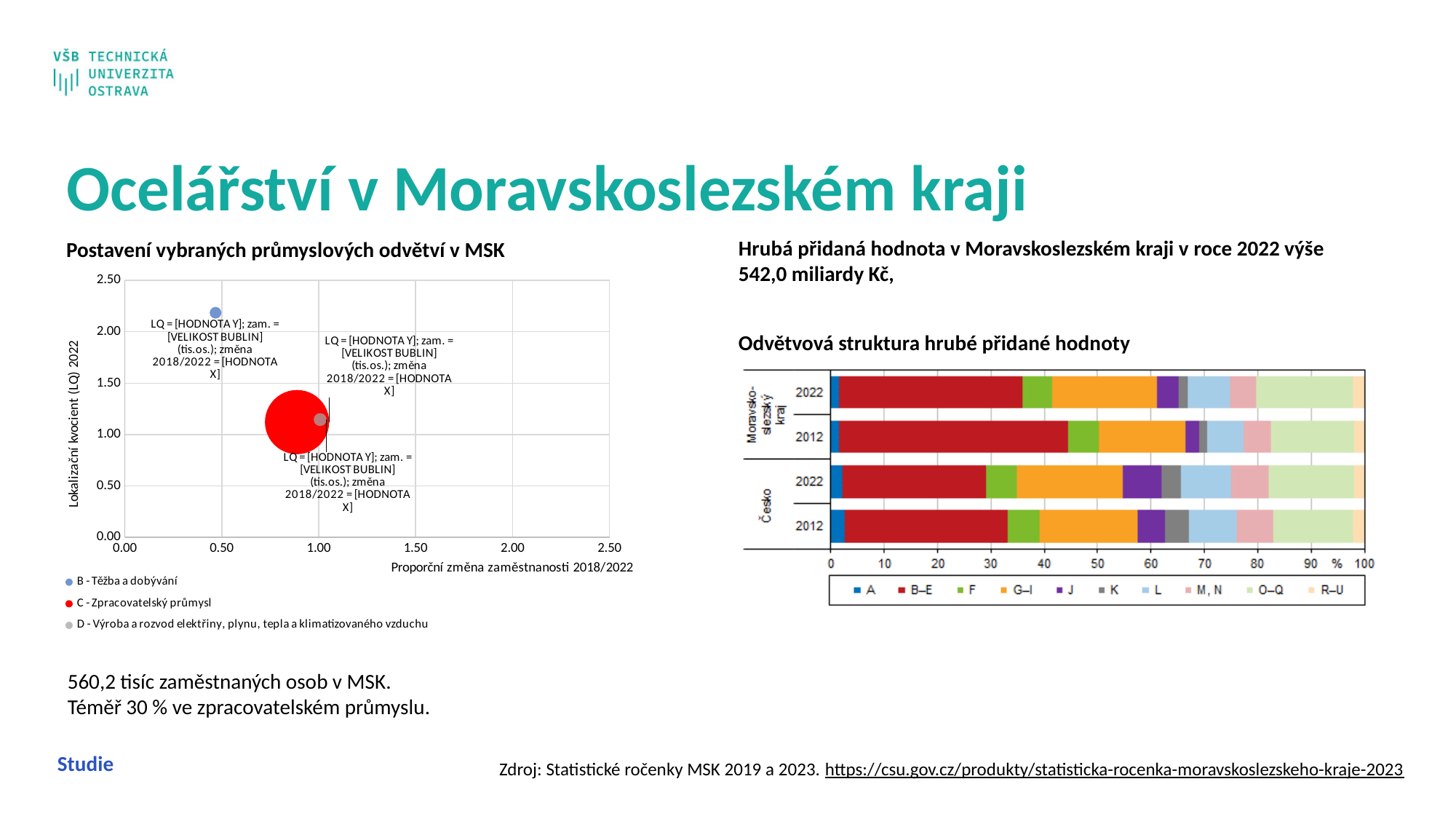
In the left chart 'Postavení vybraných průmyslových odvětví v MSK', what is the label of the x axis? Proporční změna zaměstnanosti 2018/2022 In the left chart 'Postavení vybraných průmyslových odvětví v MSK', is the LQ value for B - Těžba a dobývání greater or less than 2.00? greater In the right chart 'Odvětvová struktura hrubé přidané hodnoty', which has the larger share of B–E in 2022: Moravskoslezský kraj or Česko? Moravskoslezský kraj In the right chart 'Odvětvová struktura hrubé přidané hodnoty', how many series does the legend list? 10 What kind of chart is the right chart titled 'Odvětvová struktura hrubé přidané hodnoty'? stacked bar chart What kind of chart is the left chart titled 'Postavení vybraných průmyslových odvětví v MSK'? bubble chart In the right chart 'Odvětvová struktura hrubé přidané hodnoty', is the share of B–E for Moravskoslezský kraj in 2022 greater or less than 30 %? greater In the left chart 'Postavení vybraných průmyslových odvětví v MSK', which series is drawn with the largest bubble? C - Zpracovatelský průmysl In the left chart 'Postavení vybraných průmyslových odvětví v MSK', how many series does the legend list? 3 In the left chart 'Postavení vybraných průmyslových odvětví v MSK', which series has the highest localization quotient (LQ)? B - Těžba a dobývání In the right chart 'Odvětvová struktura hrubé přidané hodnoty', how many bars are plotted? 4 In the left chart 'Postavení vybraných průmyslových odvětví v MSK', is the LQ value for C - Zpracovatelský průmysl greater or less than 1.50? less